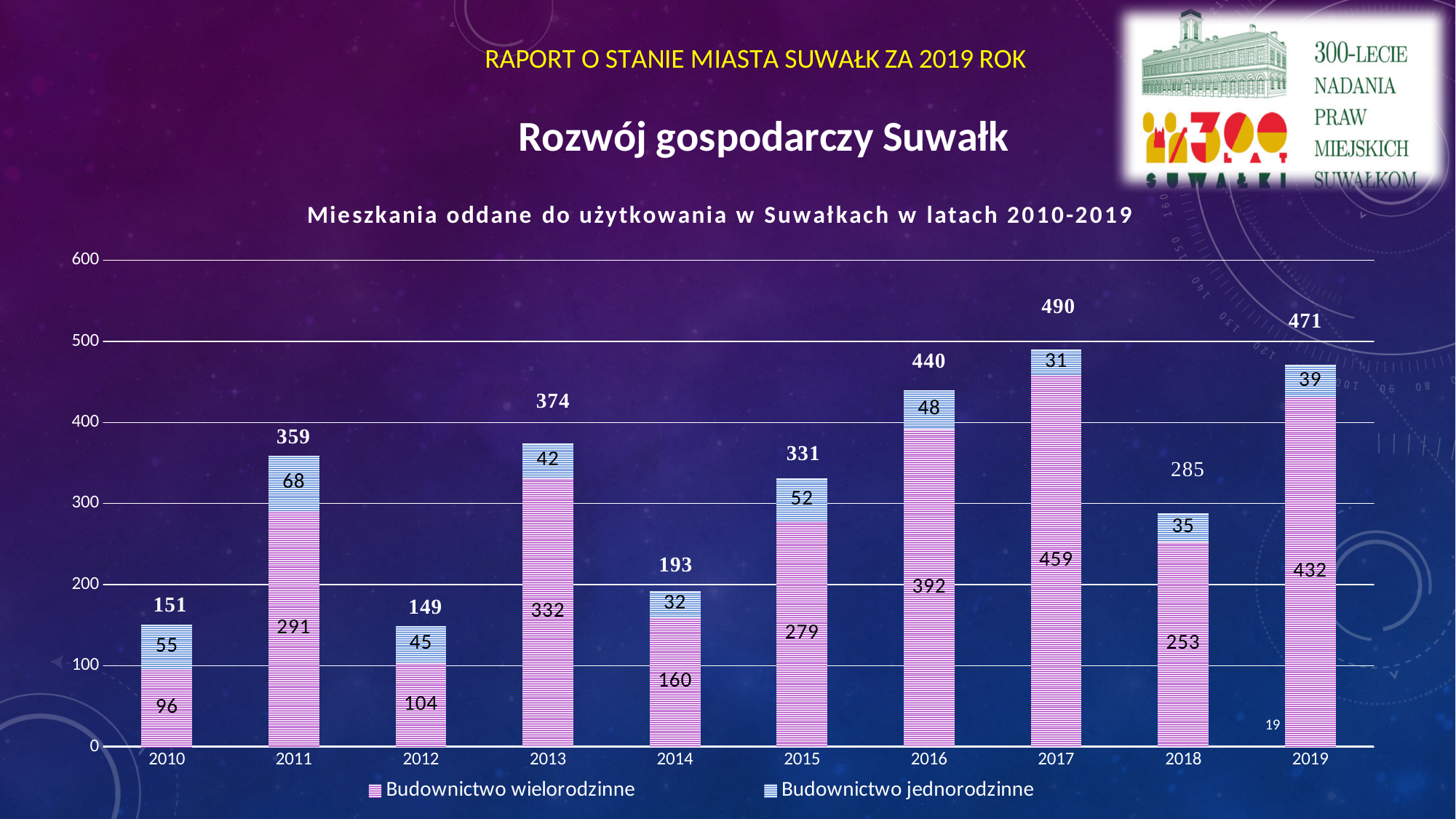
What is the total number of dwellings shown for 2016? 440 Is the total value for 2013 greater or less than 400? less Which is larger: the Budownictwo jednorodzinne value in 2010 or in 2015? 2010 Which year has the highest total value? 2017 What is the title of the chart? Mieszkania oddane do użytkowania w Suwałkach w latach 2010-2019 What is the value for Budownictwo jednorodzinne in 2011? 68 How many series does the legend list? 2 What type of chart is shown on the slide? stacked bar chart What is the difference between the Budownictwo wielorodzinne values for 2019 and 2018? 179 What is the value for Budownictwo wielorodzinne in 2017? 459 Which year has the lowest total value? 2012 How many years are shown on the x axis? 10